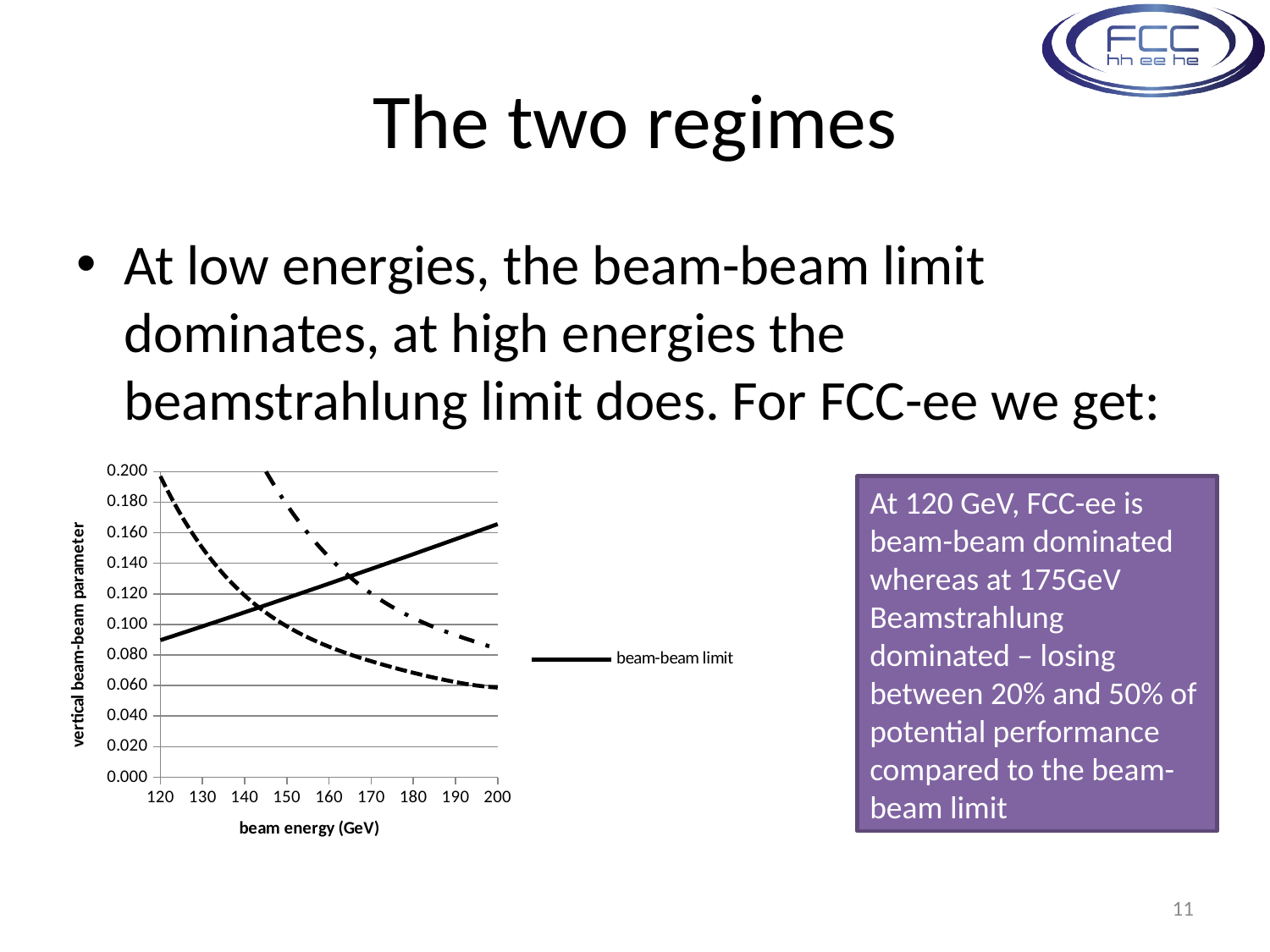
Is the value of the beam-beam limit at 200 GeV greater or less than 0.140? greater At 200 GeV, which is larger: the beam-beam limit line or the dashed line? beam-beam limit Is the value of the dashed line at 200 GeV greater or less than 0.080? less Does the dashed line rise or fall as beam energy increases along the x axis? fall Is the value of the dash-dot line at 200 GeV greater or less than 0.100? less How many lines are plotted on the chart? 3 Does the beam-beam limit line rise or fall as beam energy increases from 120 to 200 GeV? rise What is the only entry shown in the chart legend? beam-beam limit At 120 GeV, which is larger: the beam-beam limit line or the dashed line? dashed line What kind of chart is shown on the slide? line chart What is the label of the chart's y axis? vertical beam-beam parameter